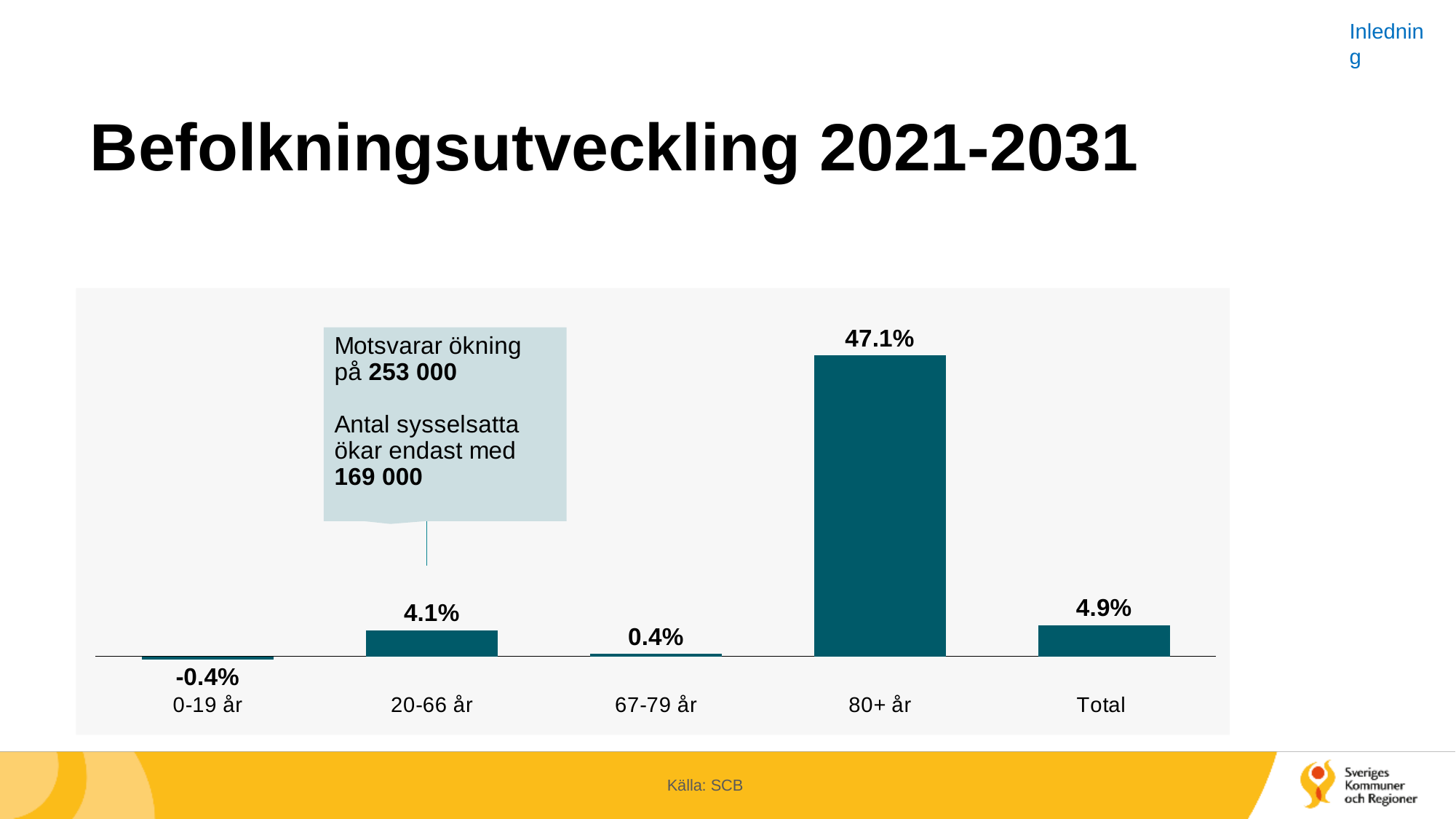
What is the difference between the values for 80+ år and Total? 42.2% What is the difference between the values for 20-66 år and 67-79 år? 3.7% What is the value for the 0-19 år category? -0.4% Which is larger, the value for 20-66 år or the value for Total? Total What kind of chart is shown on the slide? Bar chart Which category has the highest value? 80+ år What is the value for the 20-66 år category? 4.1% What is the value for the 80+ år category? 47.1% Which category has the lowest value? 0-19 år What is the value for the Total category? 4.9% What is the title of the slide containing the chart? Befolkningsutveckling 2021-2031 How many categories are shown on the x axis? 5